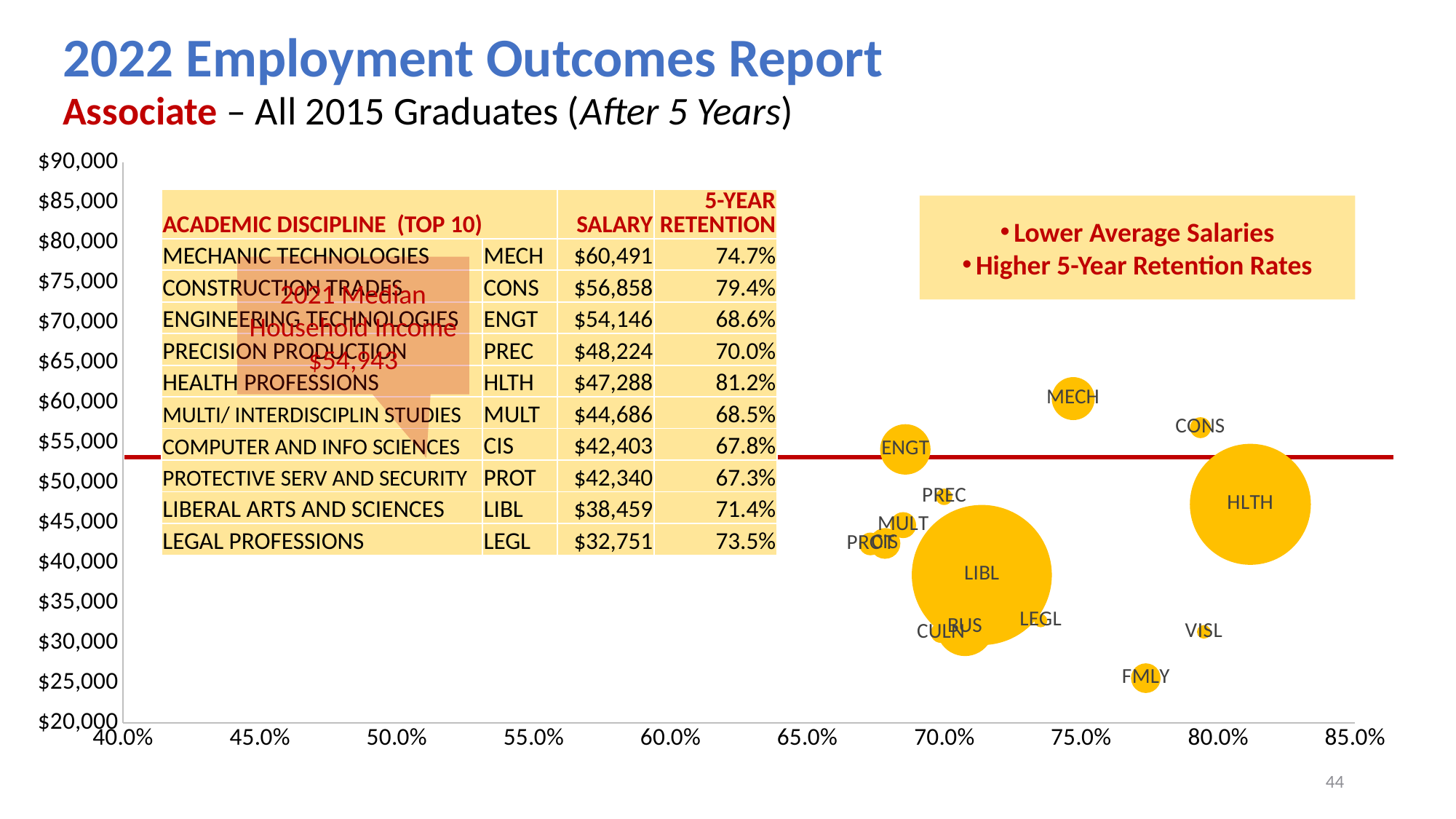
Which academic discipline in the table has the lowest salary? Legal Professions (LEGL) What is the 5-year retention rate for Health Professions (HLTH)? 81.2% What does the red horizontal line on the chart represent? 2021 Median Household Income, $54,943 Which has the higher salary, Health Professions (HLTH) or Engineering Technologies (ENGT)? Engineering Technologies (ENGT) Which academic discipline in the table has the highest salary? Mechanic Technologies (MECH) What is the difference in salary between Mechanic Technologies (MECH) and Construction Trades (CONS)? $3,633 What is the salary for Mechanic Technologies (MECH)? $60,491 Is the salary value for the FMLY bubble greater or less than $30,000? less What is the salary for Legal Professions (LEGL)? $32,751 Which academic discipline in the table has the highest 5-year retention rate? Health Professions (HLTH) What type of chart is shown on the slide? Bubble chart How many academic disciplines are listed in the table on the chart? 10